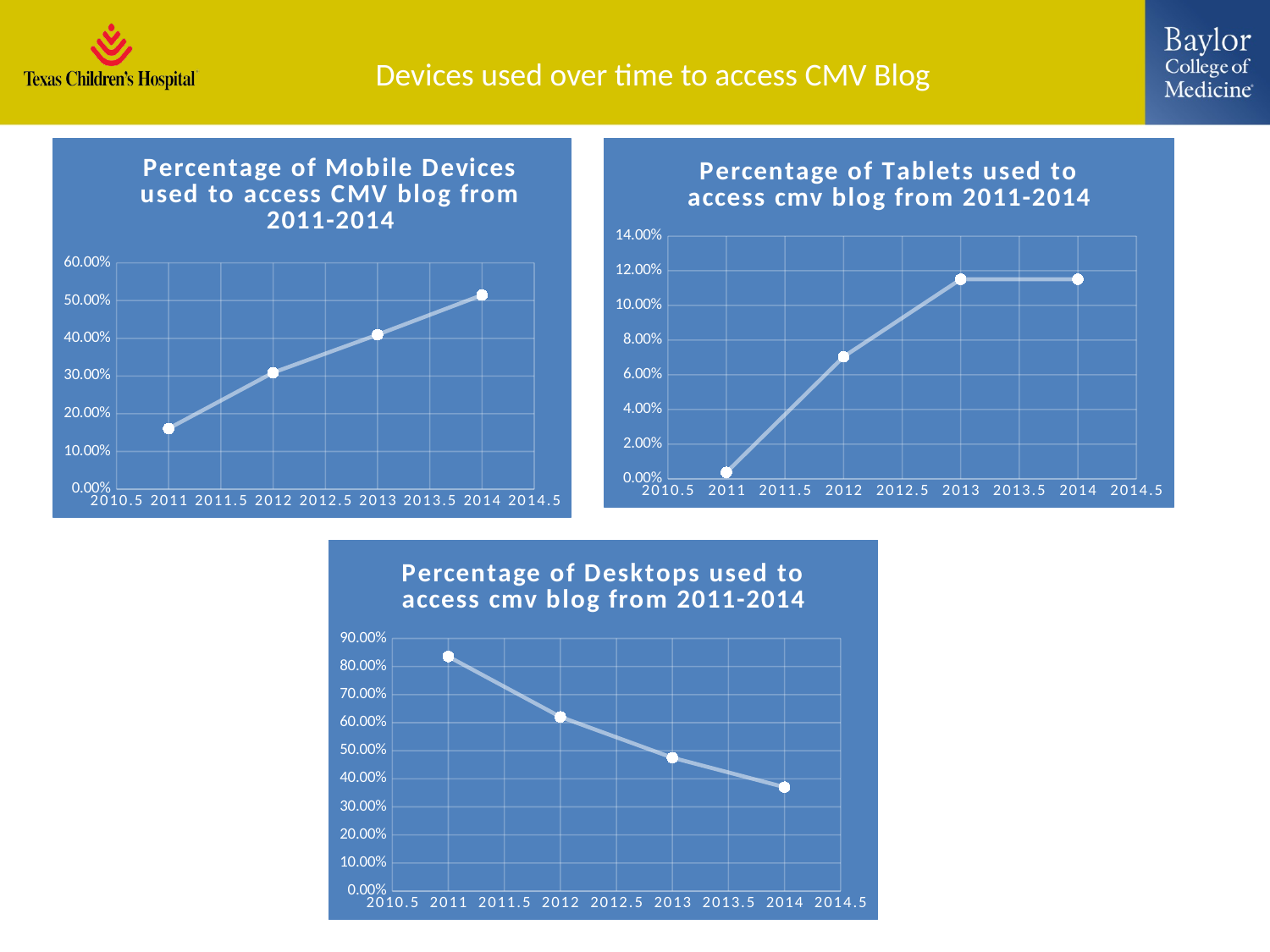
What kind of chart is the 'Percentage of Mobile Devices used to access CMV blog from 2011-2014' chart? line chart In the 'Percentage of Mobile Devices' chart, is the value for 2014 greater or less than 50.00%? greater In the 'Percentage of Tablets' chart, is the value for 2012 greater or less than 6.00%? greater In the 'Percentage of Mobile Devices' chart, which is larger, the value for 2012 or the value for 2013? 2013 In the 'Percentage of Desktops' chart, which year has the highest value? 2011 In the 'Percentage of Mobile Devices' chart, is the value for 2011 greater or less than 20.00%? less In the 'Percentage of Mobile Devices' chart, do the values rise or fall from 2011 to 2014? rise In the 'Percentage of Desktops' chart, do the values rise or fall from 2011 to 2014? fall In the 'Percentage of Tablets' chart, which year has the lowest value? 2011 How many data points are plotted in the 'Percentage of Tablets' chart? 4